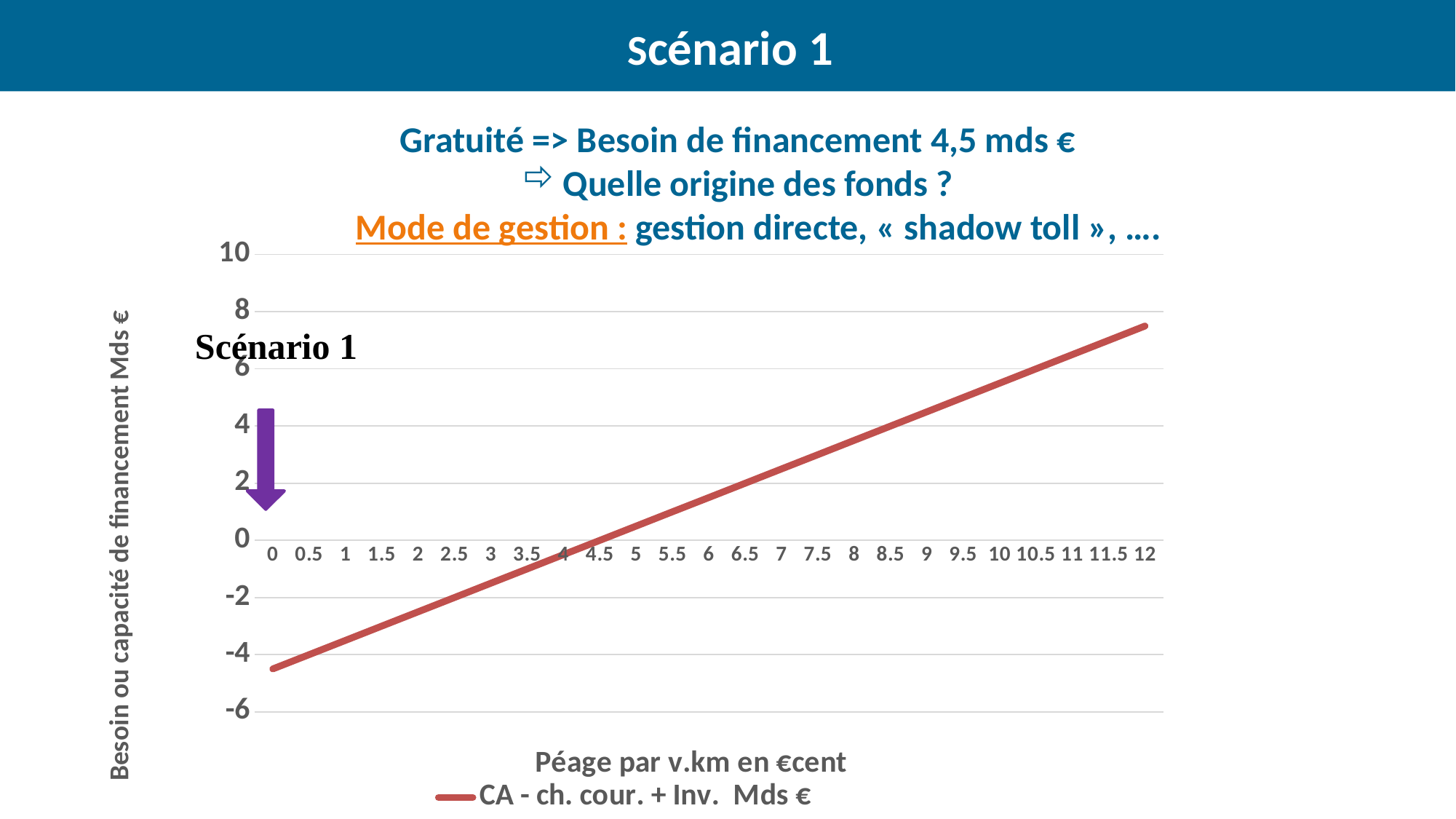
Is the value for x = 6 greater or less than 0? greater What is the legend entry for the plotted line? CA - ch. cour. + Inv. Mds € Is the value for x = 10 greater or less than 4? greater At which x value is the plotted line highest? 12 How many series does the legend list? 1 How many tick labels are shown on the x axis? 25 Is the value for x = 3 greater or less than 0? less What is the title of the x axis? Péage par v.km en €cent What kind of chart is shown on the slide? line chart Do the values rise or fall as the x axis goes from 0 to 12? rise